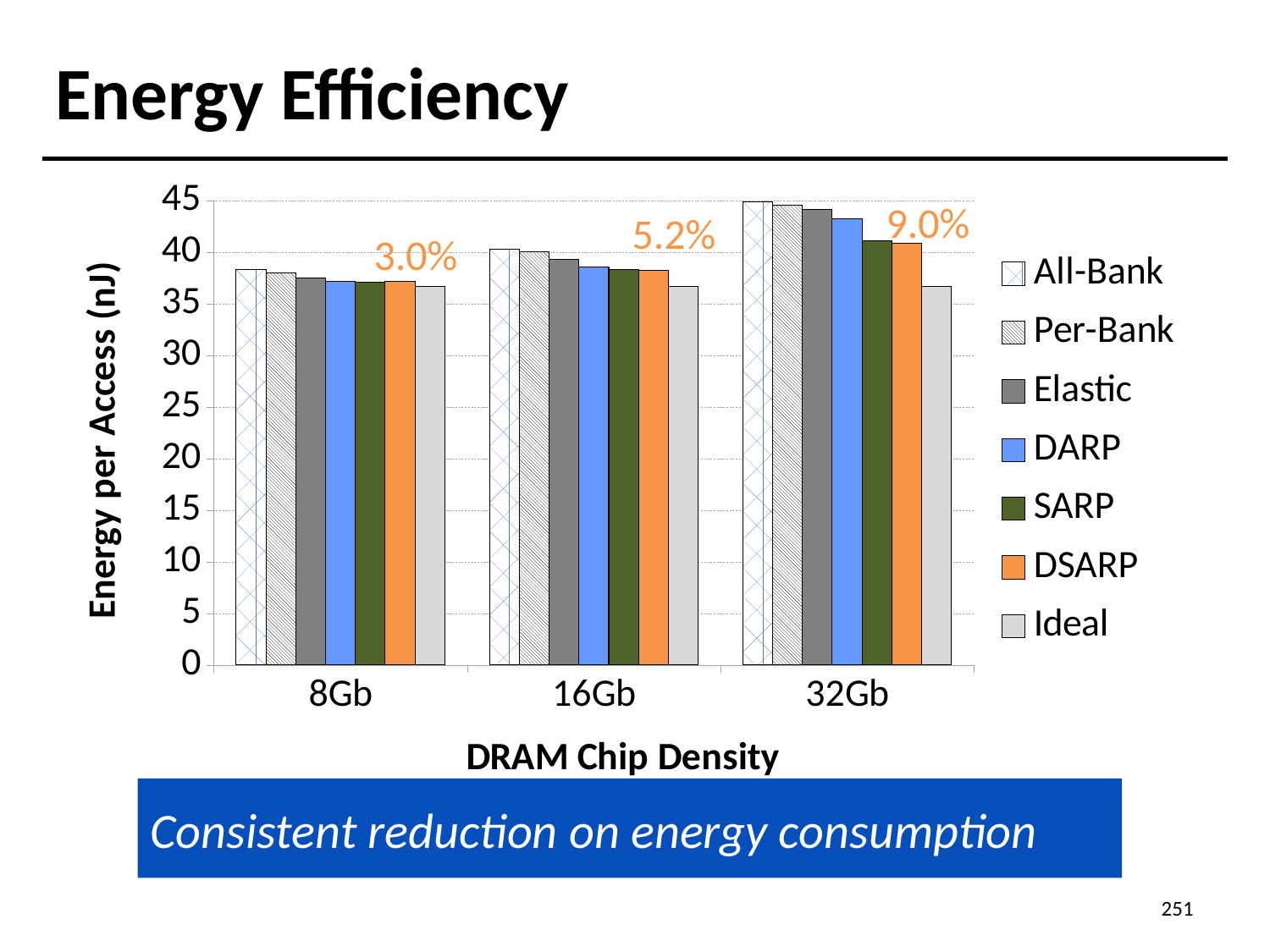
Is the All-Bank value for 32Gb greater or less than 40? greater What is the title of the y axis? Energy per Access (nJ) Is the Ideal value for 32Gb greater or less than 40? less At 32Gb, which is larger: the All-Bank value or the Ideal value? All-Bank For which DRAM chip density is the All-Bank energy per access highest? 32Gb How many DRAM chip density categories are shown on the x axis? 3 What percentage is annotated above the 32Gb group of bars? 9.0% Is the DARP value for 16Gb greater or less than 40? less What kind of chart is shown on the slide? bar chart Does the All-Bank energy per access rise or fall as DRAM chip density increases from 8Gb to 32Gb? rise How many series does the legend list? 7